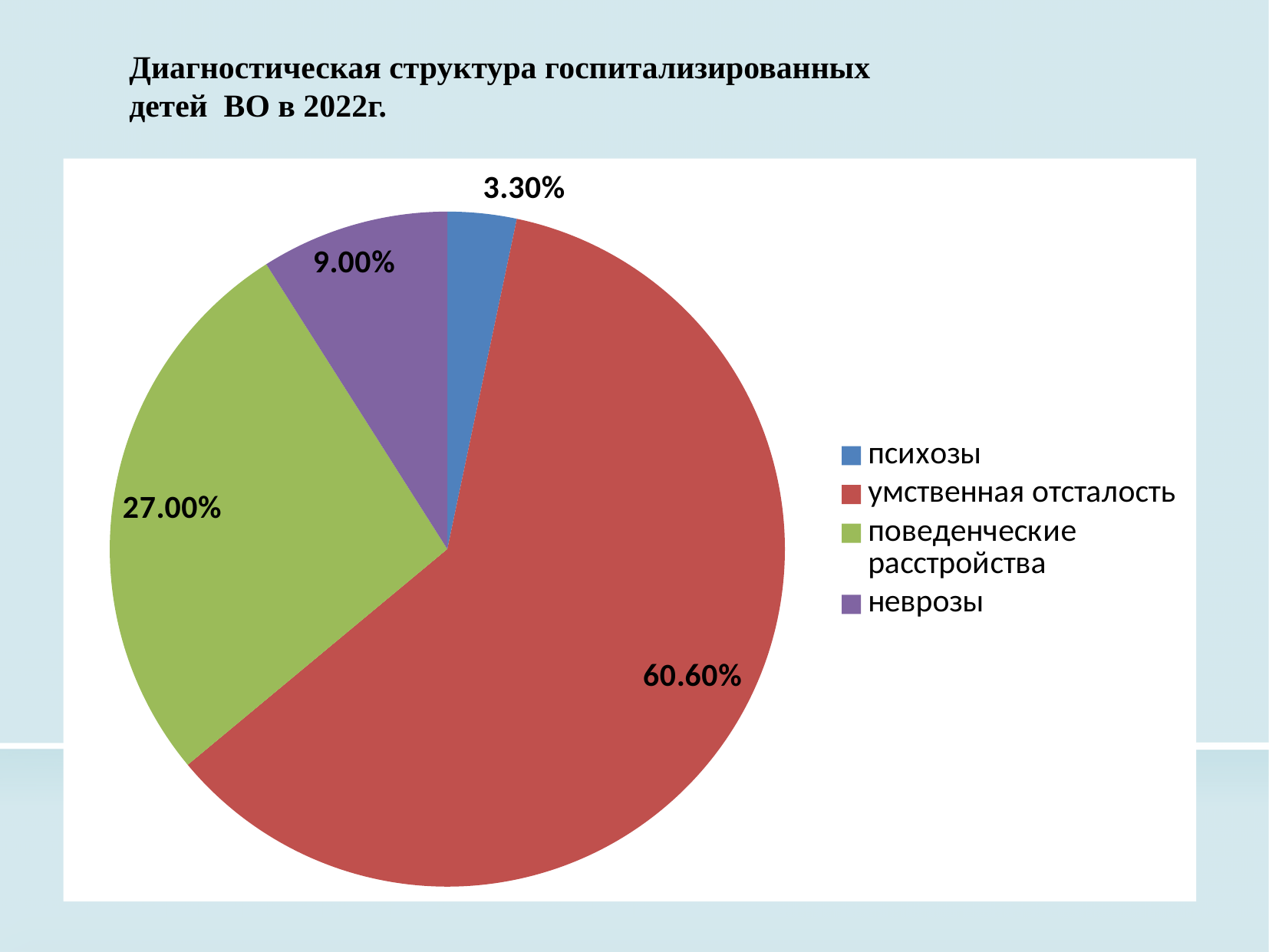
Which category has the smallest slice of the pie? психозы How many categories does the pie chart have? 4 What share of the pie does умственная отсталость have? 60.60% What is the value shown for психозы? 3.30% What colour is the slice for умственная отсталость? red What is the value shown for неврозы? 9.00% What is the difference between the values for неврозы and психозы? 5.70% Which is larger, the slice for поведенческие расстройства or the slice for неврозы? поведенческие расстройства What is the value shown for поведенческие расстройства? 27.00% Which category has the largest slice of the pie? умственная отсталость What is the difference between the values for умственная отсталость and поведенческие расстройства? 33.60% What type of chart is shown on the slide? pie chart